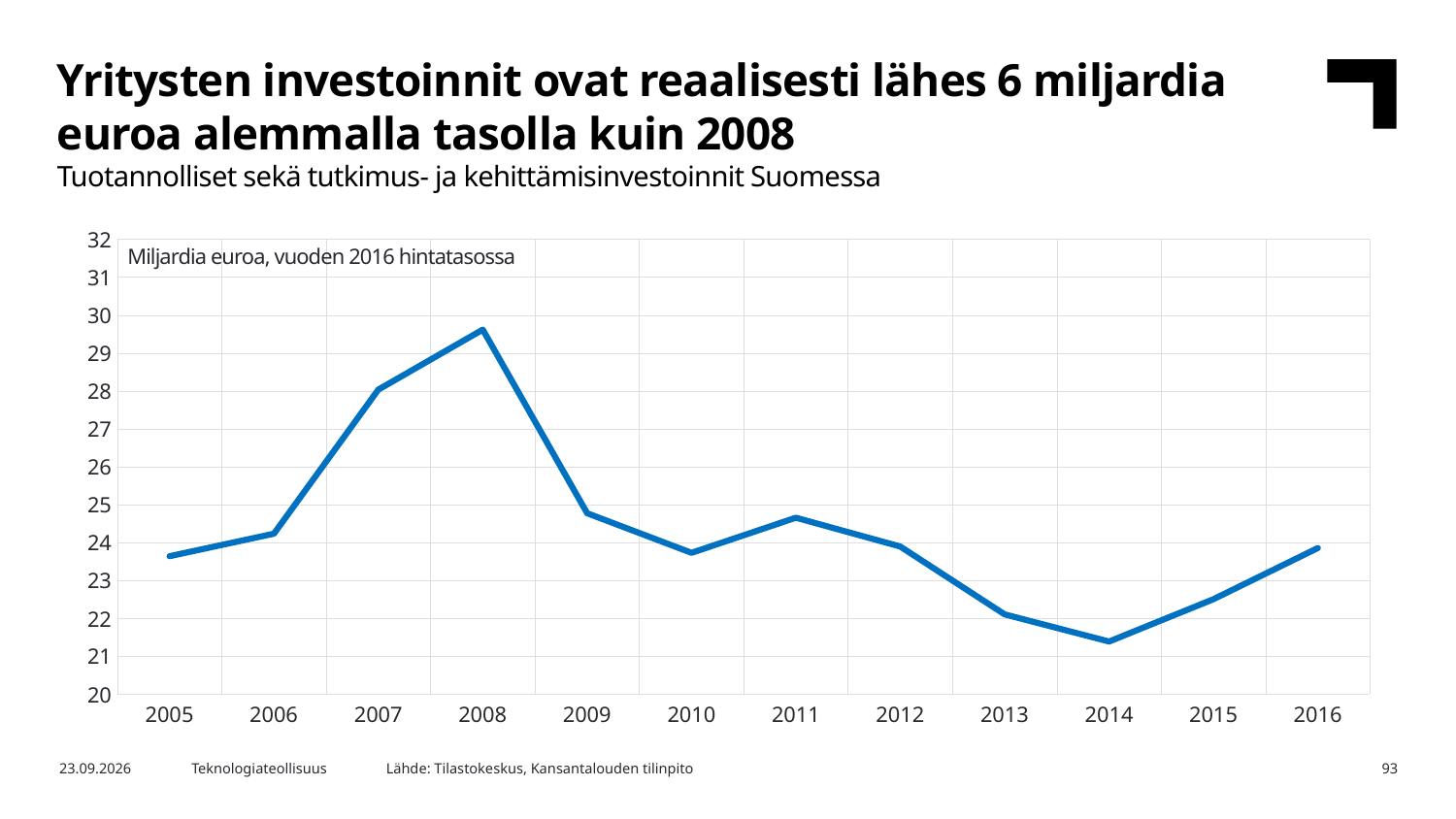
In which year is the investment value highest? 2008 Is the value for 2007 greater or less than 27? greater In which year is the investment value lowest? 2014 Which year has a higher value, 2007 or 2009? 2007 Do the values rise or fall from 2008 to 2010? fall Is the value for 2014 greater or less than 22? less What kind of chart is shown on the slide? line chart Is the value for 2013 greater or less than 23? less How many years are plotted on the x axis? 12 Which year has a higher value, 2011 or 2013? 2011 What unit is stated in the label inside the chart area? Miljardia euroa, vuoden 2016 hintatasossa